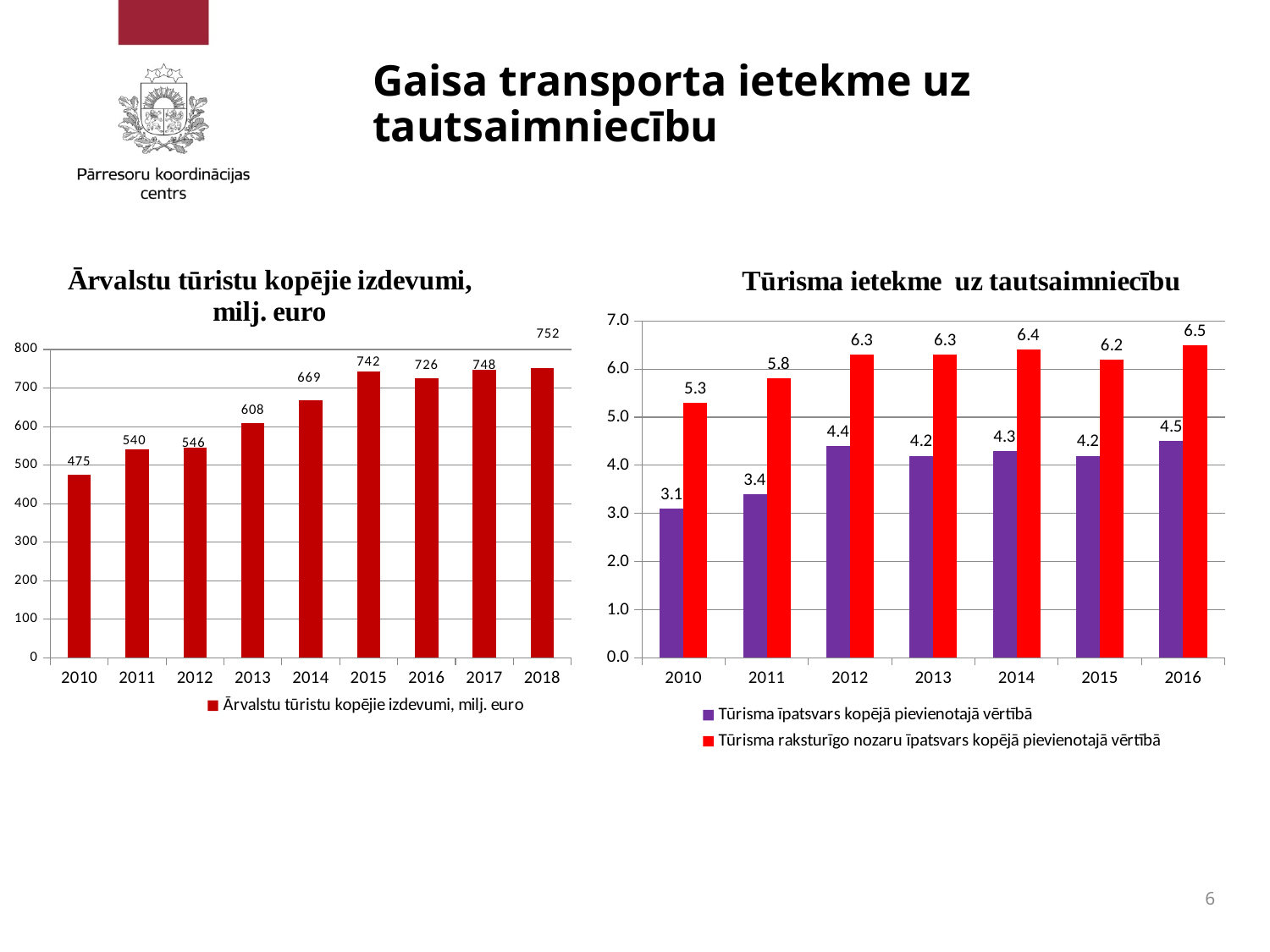
In the left chart 'Ārvalstu tūristu kopējie izdevumi, milj. euro', how many years are shown on the x axis? 9 In the right chart 'Tūrisma ietekme uz tautsaimniecību', what is the value of 'Tūrisma raksturīgo nozaru īpatsvars kopējā pievienotajā vērtībā' for 2011? 5.8 In the left chart 'Ārvalstu tūristu kopējie izdevumi, milj. euro', is the value for 2015 greater or less than 2016? Greater In the left chart 'Ārvalstu tūristu kopējie izdevumi, milj. euro', what is the value for 2014? 669 In the left chart 'Ārvalstu tūristu kopējie izdevumi, milj. euro', which year has the lowest value? 2010 In the left chart 'Ārvalstu tūristu kopējie izdevumi, milj. euro', what is the difference between the values for 2018 and 2010? 277 In the right chart 'Tūrisma ietekme uz tautsaimniecību', what is the difference between the two series' values in 2016? 2.0 In the left chart 'Ārvalstu tūristu kopējie izdevumi, milj. euro', which year has the highest value? 2018 In the right chart 'Tūrisma ietekme uz tautsaimniecību', how many series does the legend list? 2 In the right chart 'Tūrisma ietekme uz tautsaimniecību', which year has the highest value for 'Tūrisma raksturīgo nozaru īpatsvars kopējā pievienotajā vērtībā'? 2016 What kind of chart is the right chart 'Tūrisma ietekme uz tautsaimniecību'? Bar chart In the right chart 'Tūrisma ietekme uz tautsaimniecību', what is the value of 'Tūrisma īpatsvars kopējā pievienotajā vērtībā' for 2012? 4.4